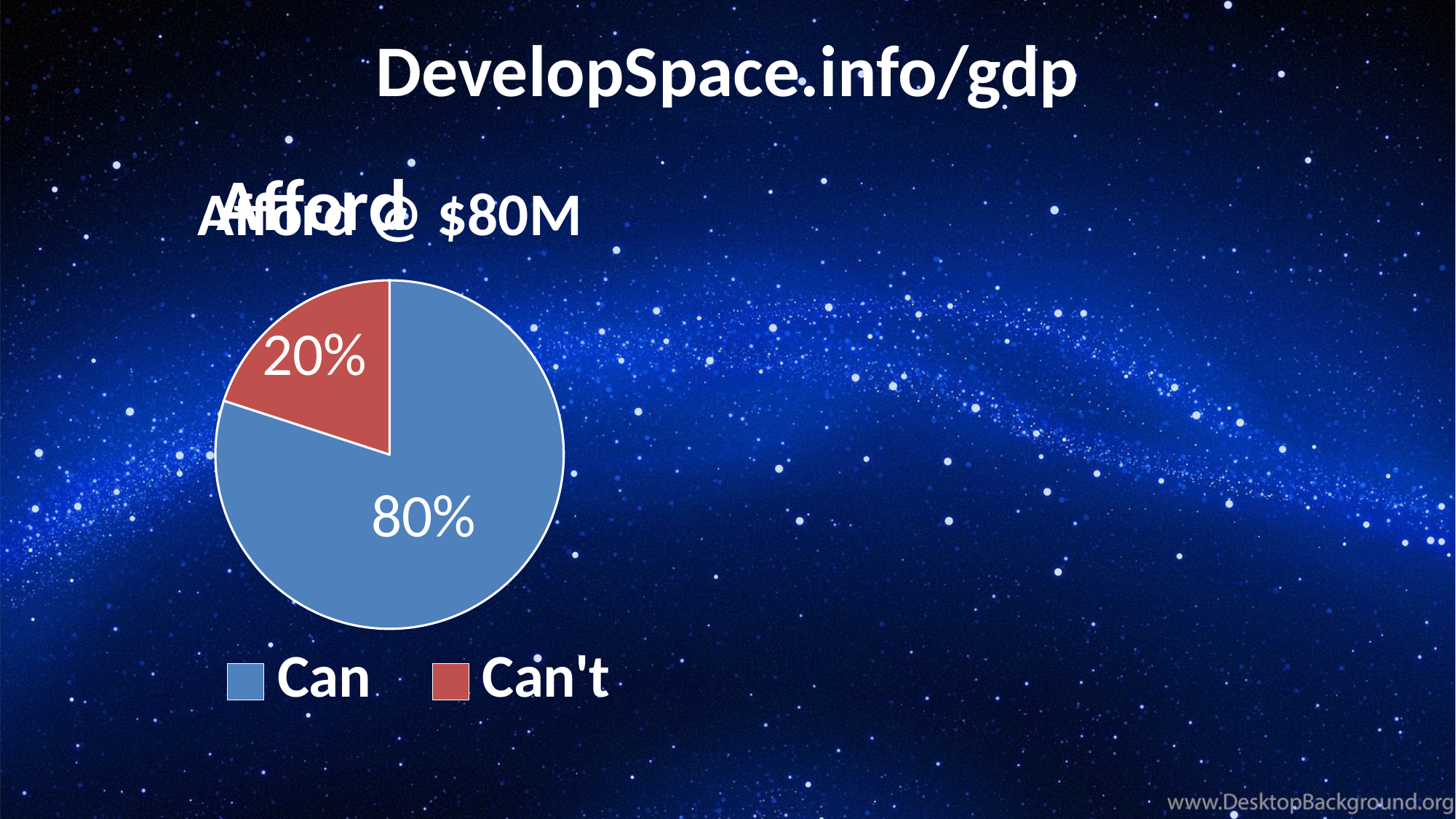
What kind of chart is shown on the slide? pie chart Is the share for "Can't" greater or less than 50%? less What is the difference in percentage points between the "Can" and "Can't" slices? 60 Which is larger, the "Can" slice or the "Can't" slice? Can Which slice of the pie is the largest? Can What share of the pie does the "Can" slice represent? 80% What colour is the "Can" slice in the pie chart? blue What share of the pie does the "Can't" slice represent? 20% How many entries does the legend list? 2 How many slices does the pie chart have? 2 Which slice of the pie is the smallest? Can't What colour is the "Can't" slice in the pie chart? red